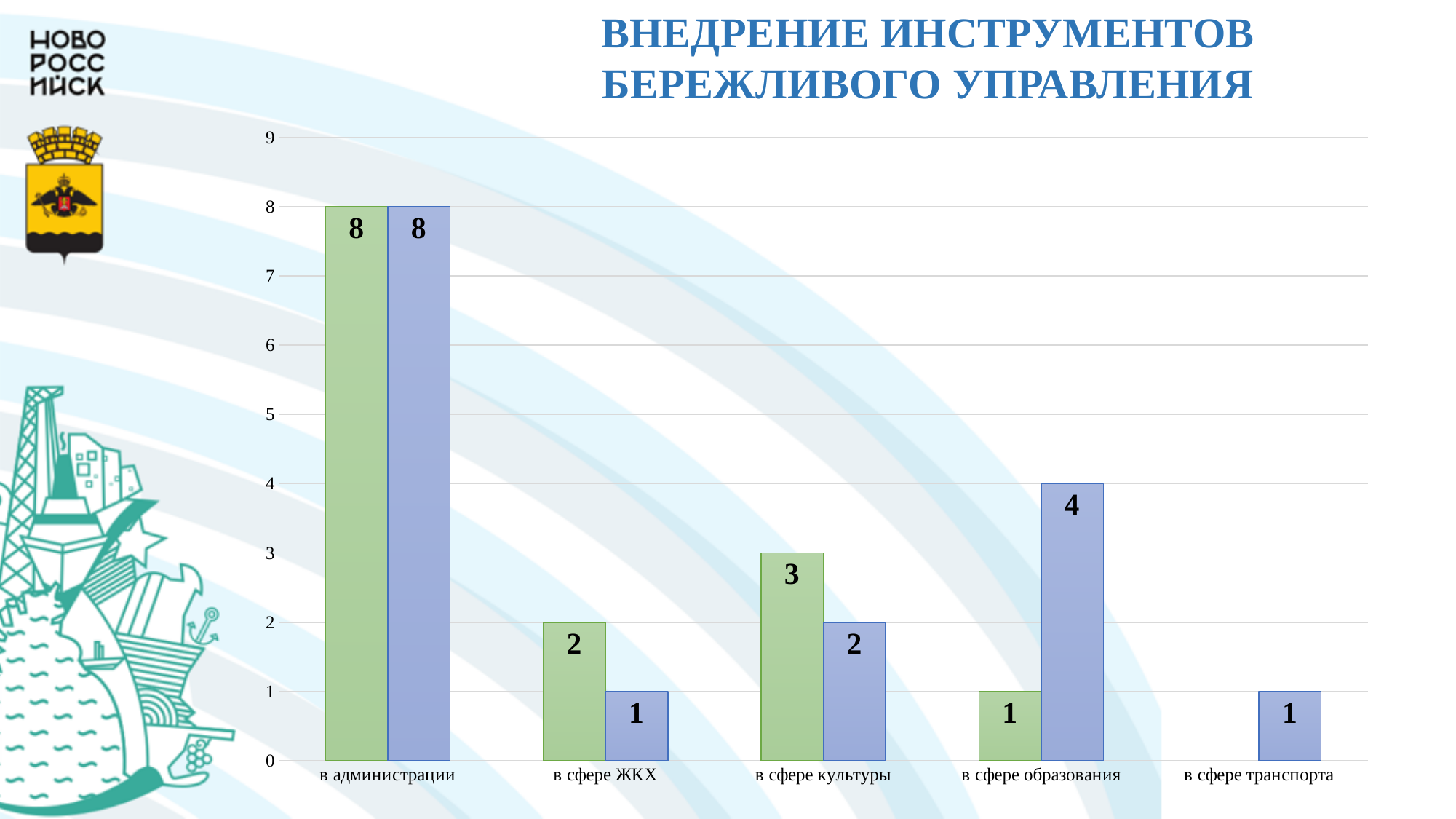
What is the difference between the blue bar and the green bar for "в сфере образования"? 3 What type of chart is shown on the slide? bar chart How many categories are shown on the x axis? 5 Which category has the highest blue bar? в администрации What is the value of the green bar for "в сфере культуры"? 3 What is the value of the green bar for "в администрации"? 8 Which category has the lowest green bar? в сфере образования What is the value of the blue bar for "в сфере образования"? 4 What is the value of the blue bar for "в сфере транспорта"? 1 What is the title of the slide? ВНЕДРЕНИЕ ИНСТРУМЕНТОВ БЕРЕЖЛИВОГО УПРАВЛЕНИЯ What is the value of the blue bar for "в сфере ЖКХ"? 1 For "в сфере ЖКХ", which is larger: the green bar or the blue bar? the green bar